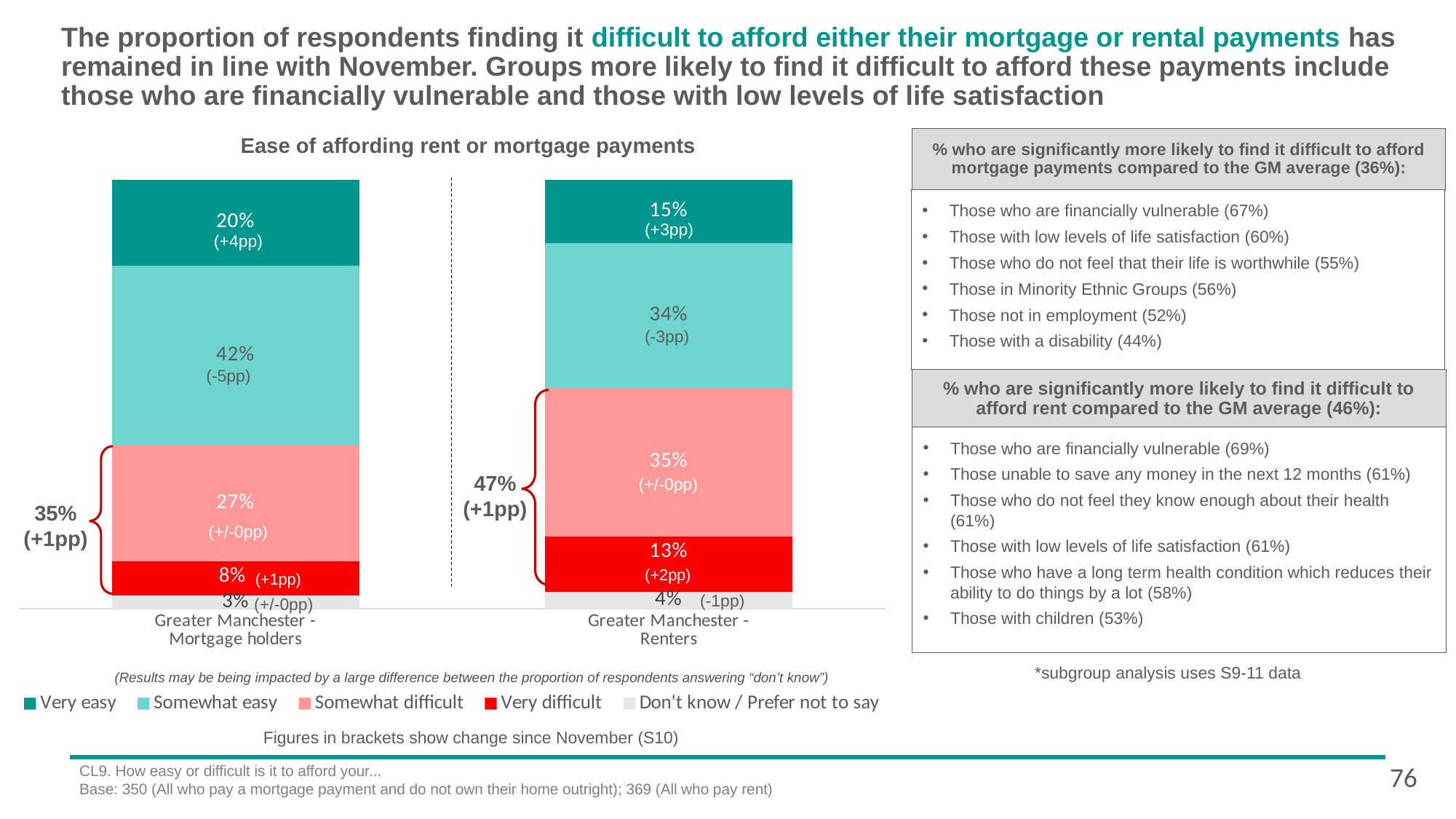
How many categories (bars) are plotted in the chart? 2 What is the combined share of mortgage holders finding it somewhat or very difficult to afford their payments, as shown by the bracket? 35% How many series does the chart legend list? 5 What kind of chart is shown on the slide? Stacked bar chart What percentage of Greater Manchester renters find it very difficult to afford their payments? 13% What percentage of Greater Manchester renters answered 'Very easy'? 15% What percentage of Greater Manchester mortgage holders find it somewhat easy to afford their payments? 42% Which response category is the smallest for Greater Manchester renters? Don't know / Prefer not to say What is the difference between the 'Somewhat difficult' share for renters and for mortgage holders? 8 percentage points Which response category is the largest for Greater Manchester mortgage holders? Somewhat easy Which group has a larger 'Very difficult' share, mortgage holders or renters? Renters What is the title of the chart? Ease of affording rent or mortgage payments